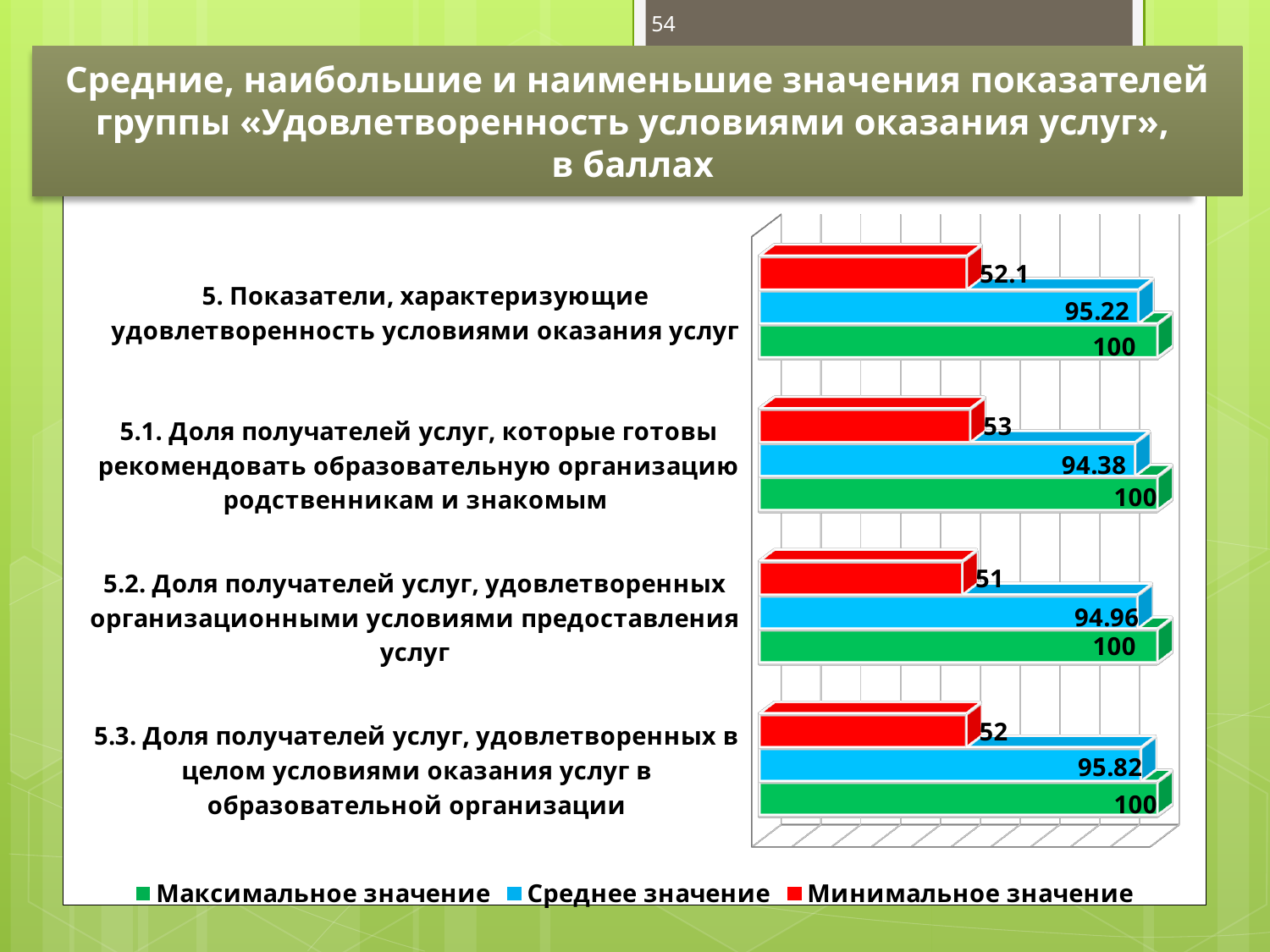
Which indicator has the lowest minimum value (Минимальное значение)? 5.2 How many indicators (categories) are shown in the chart? 4 What is the difference between the maximum and minimum values for indicator 5? 47.9 Which indicator has the highest average value (Среднее значение)? 5.3 Which is larger: the minimum value for indicator 5.1 or for indicator 5.3? 5.1 What is the average value (Среднее значение) for indicator 5.3? 95.82 How many series does the legend list? 3 What is the difference between the average values of indicator 5.3 and indicator 5.1? 1.44 What is the maximum value (Максимальное значение) for indicator 5.2? 100 What type of chart is shown on the slide? Bar chart What is the average value (Среднее значение) for indicator 5? 95.22 What is the minimum value (Минимальное значение) for indicator 5.1? 53